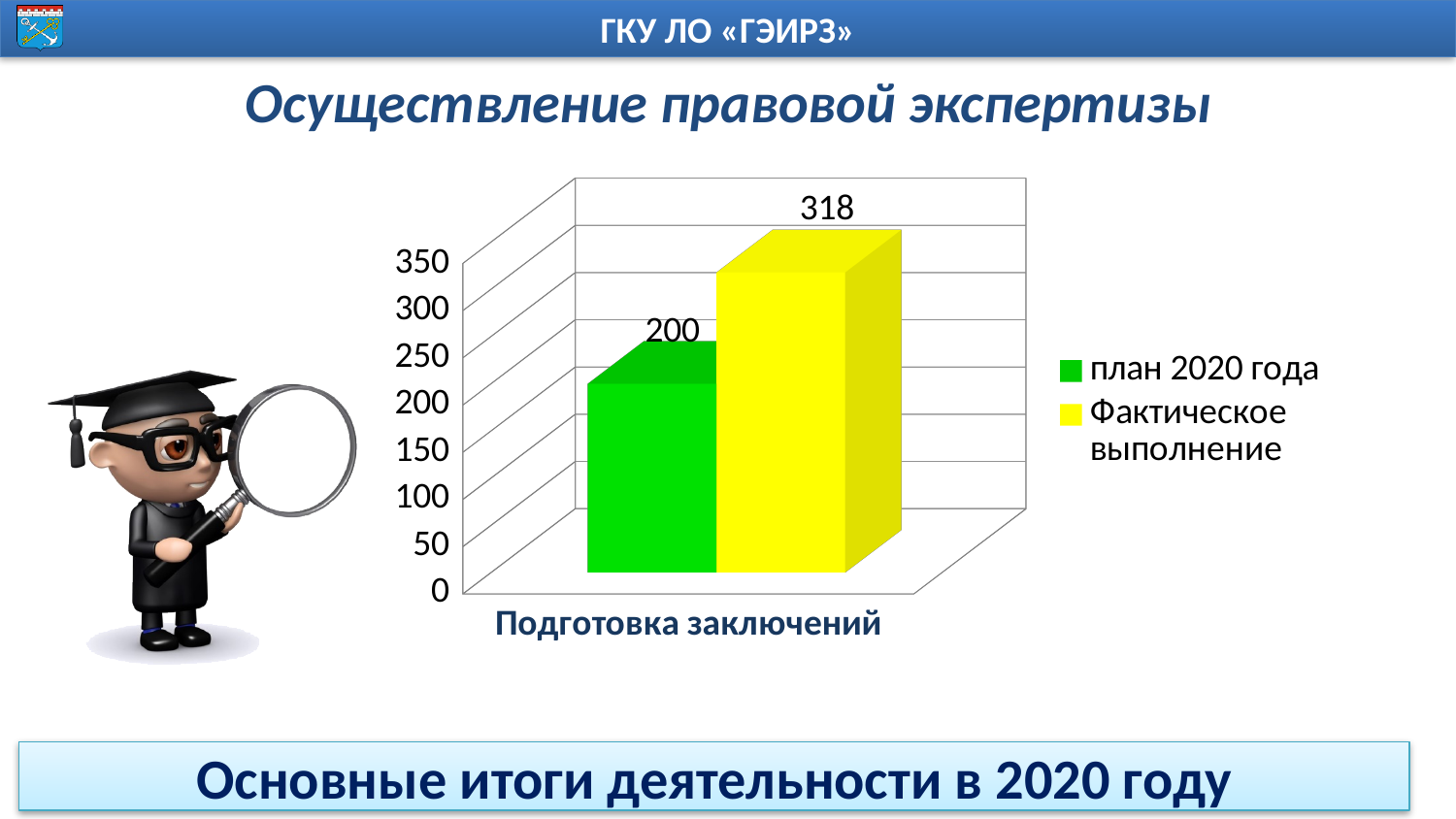
What is the difference between "Фактическое выполнение" and "план 2020 года"? 118 What is the value for "план 2020 года" in the "Подготовка заключений" category? 200 Is the value for "план 2020 года" greater or less than 250? less How many series does the legend list? 2 What is the value for "Фактическое выполнение" in the "Подготовка заключений" category? 318 Is the value for "Фактическое выполнение" greater or less than 300? greater Which series has the higher value: "план 2020 года" or "Фактическое выполнение"? Фактическое выполнение What kind of chart is shown on the slide? bar chart What colour is the bar for "Фактическое выполнение"? yellow What is the highest value shown on the vertical axis? 350 How many categories are shown on the x axis? 1 What is the category label on the x axis? Подготовка заключений